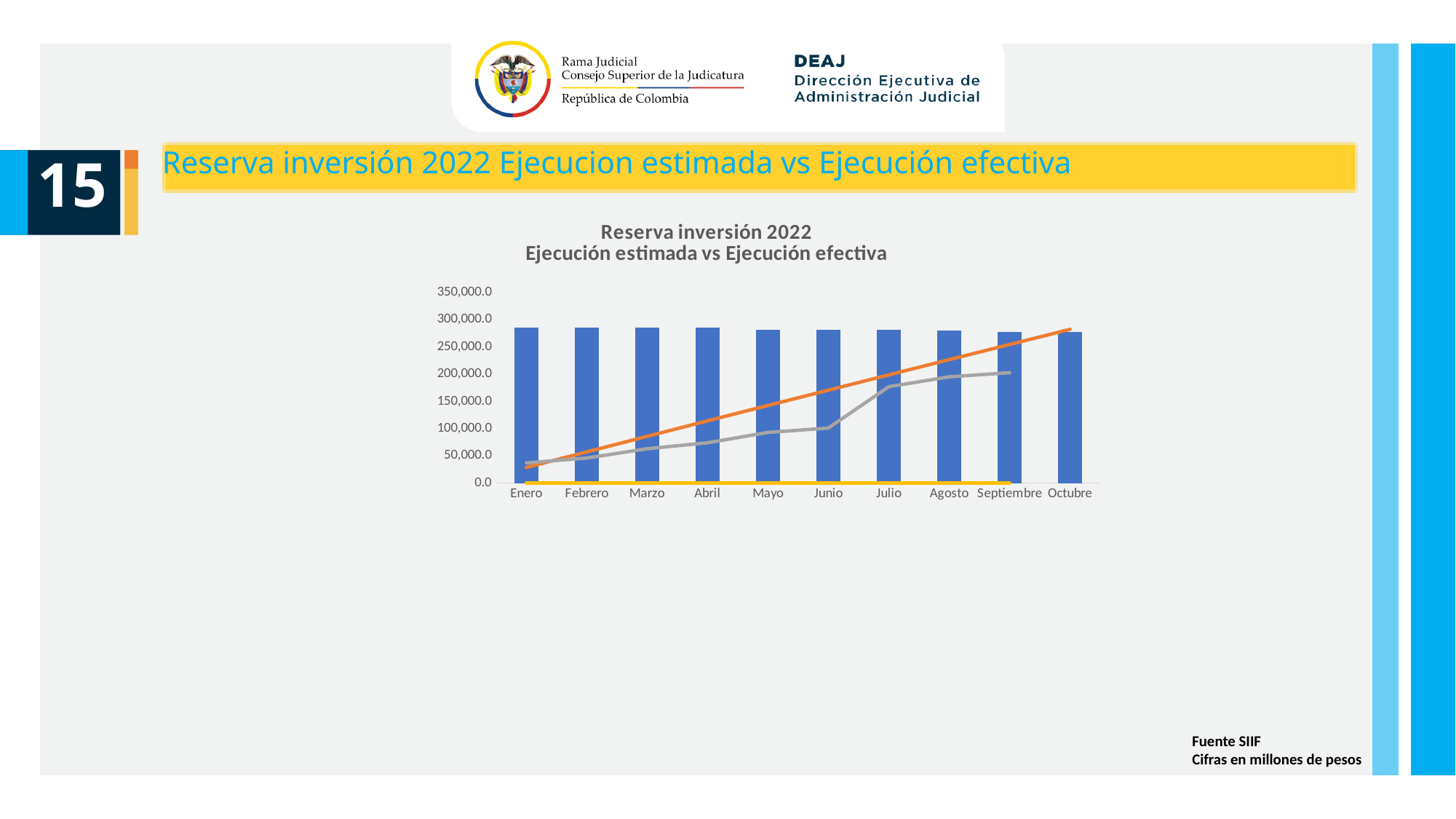
In Septiembre, which is higher: the orange line or the gray line? the orange line How many months are shown on the x axis of the chart? 10 What is the highest value shown on the vertical axis of the chart? 350,000.0 Does the orange line rise or fall from Enero to Octubre? rises What kind of chart is shown on the slide? A combination bar and line chart Is the gray line's value for Septiembre greater or less than 150,000? greater Is the blue bar for Enero greater or less than 250,000? greater Is the orange line's value for Octubre greater or less than 250,000? greater In Enero, which is higher: the blue bar or the orange line? the blue bar What is the title of the chart? Reserva inversión 2022 Ejecución estimada vs Ejecución efectiva